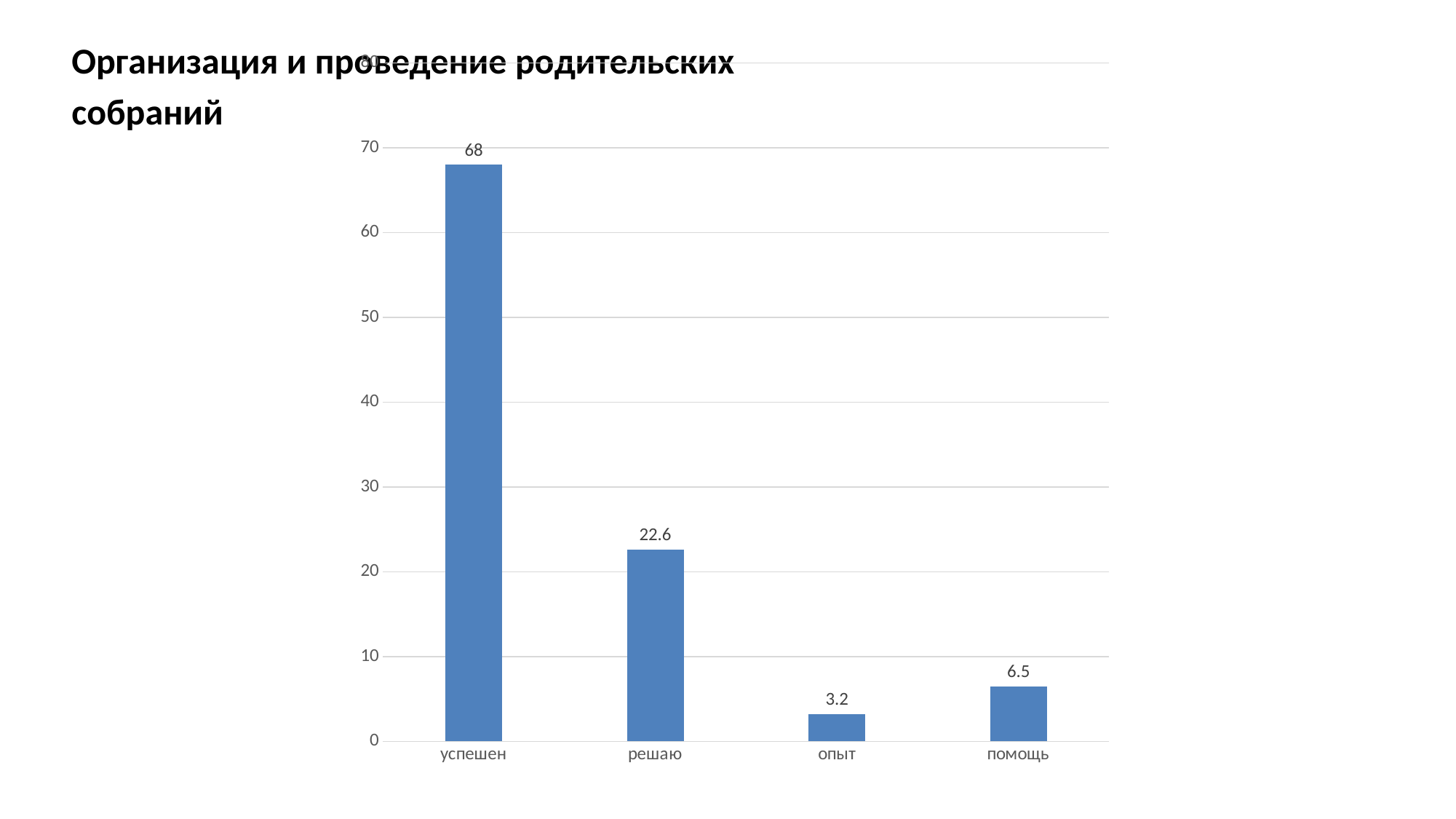
What is the difference between the values for помощь and опыт? 3.3 Which category has the lowest value? опыт Is the value for решаю greater or less than 20? greater What kind of chart is shown on the slide? bar chart What is the value for успешен? 68 What is the value for помощь? 6.5 Which is larger, the value for помощь or the value for опыт? помощь What is the difference between the values for успешен and решаю? 45.4 Which category has the highest value? успешен What is the value for опыт? 3.2 What is the value for решаю? 22.6 How many categories are shown on the x axis? 4